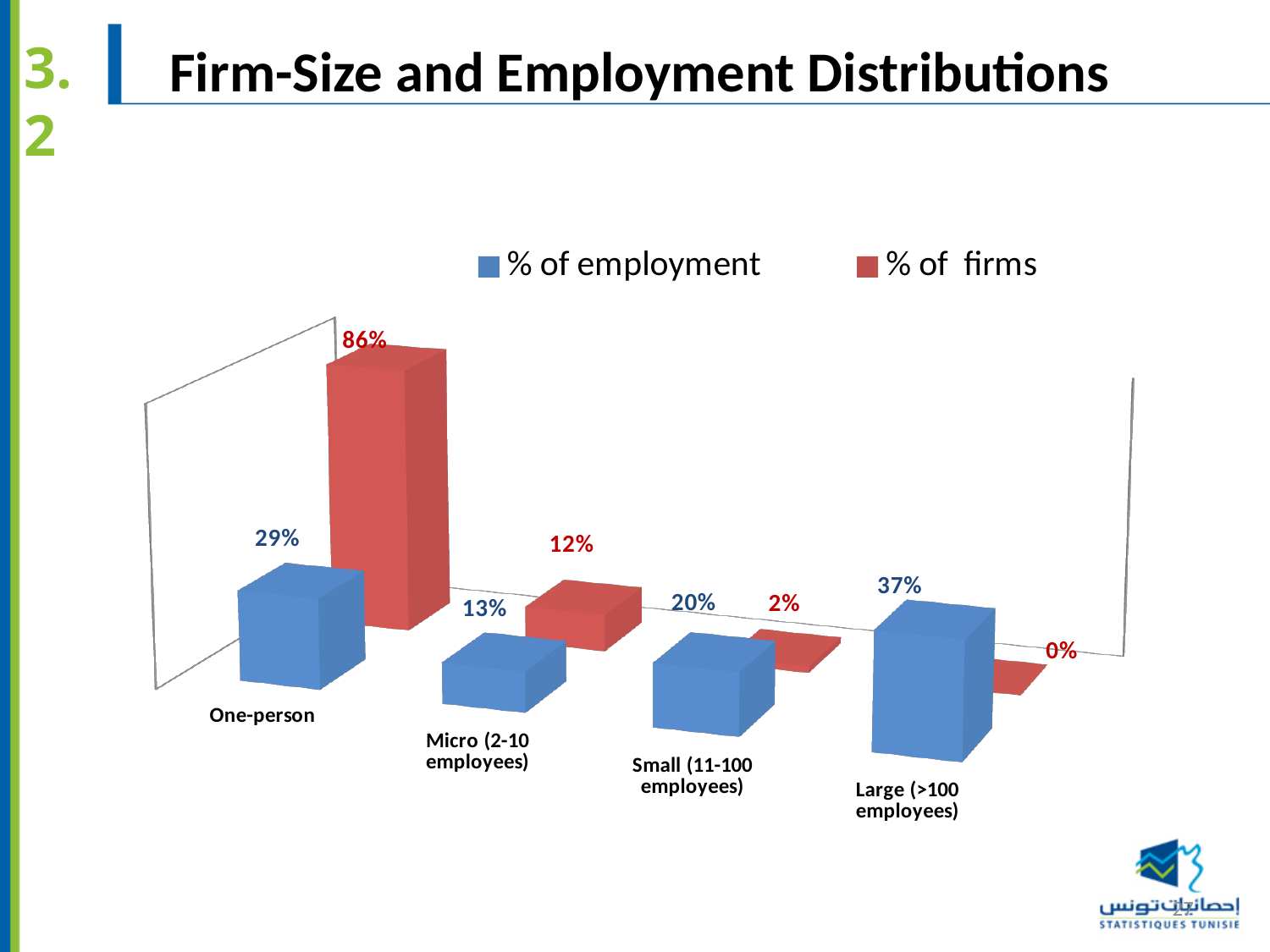
Which firm-size category has the highest % of employment? Large (>100 employees) What is the % of employment for Micro (2-10 employees) firms? 13% What kind of chart is shown on the slide? Bar chart How many series does the legend list? 2 Which firm-size category has the lowest % of firms? Large (>100 employees) What is the % of firms for One-person firms? 86% How many firm-size categories are shown on the x axis? 4 What is the % of firms for Small (11-100 employees) firms? 2% Does the % of firms rise or fall from One-person to Large (>100 employees) firms? Fall What is the % of employment for Large (>100 employees) firms? 37% What is the difference between the % of firms and the % of employment for One-person firms? 57% Which is larger for Small (11-100 employees) firms: % of employment or % of firms? % of employment